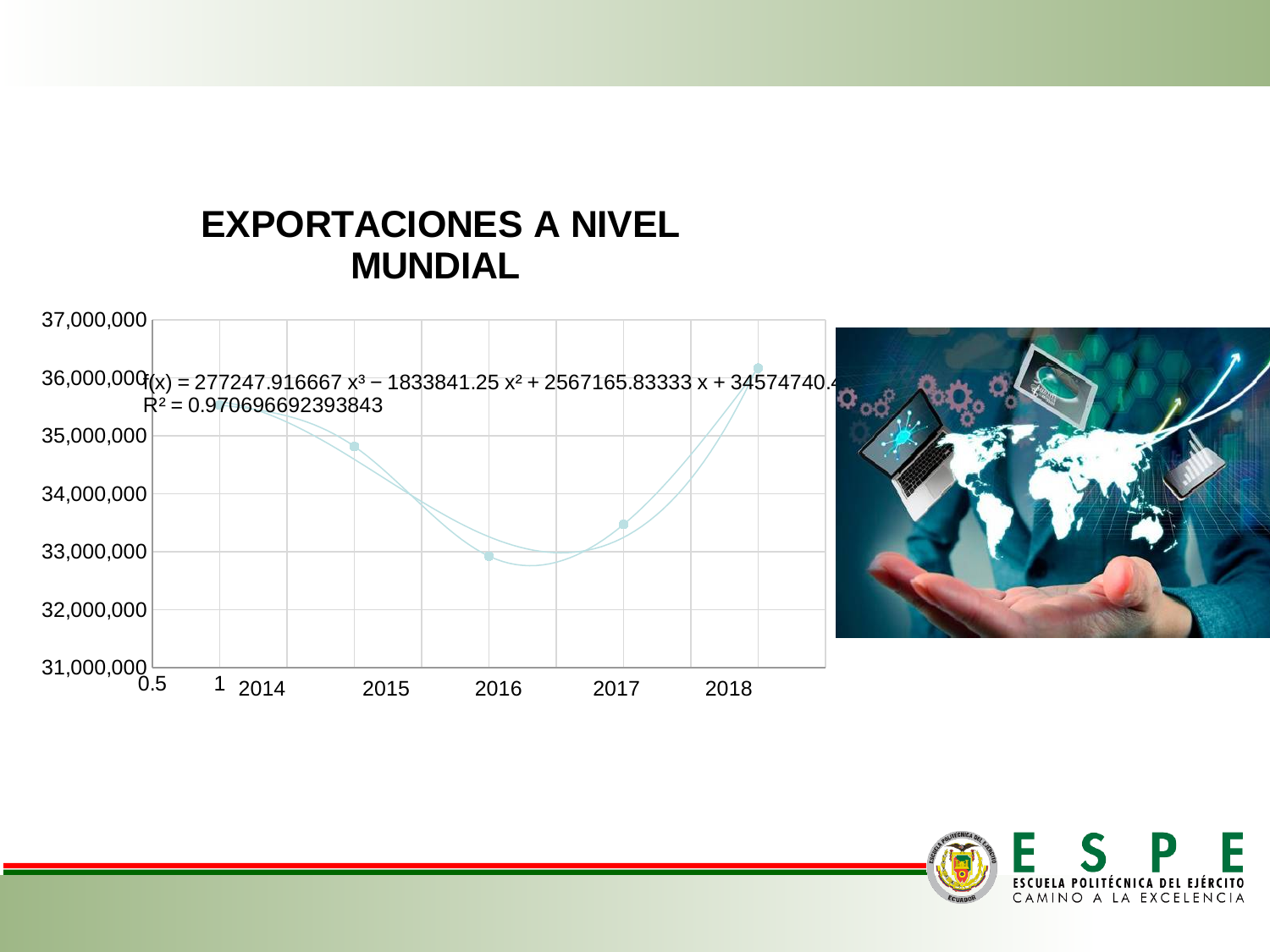
What R² value is printed on the chart? 0.970696692393843 Which year has the highest value on the chart? 2018 Do the values rise or fall from 2014 to 2016? fall Is the value for 2016 greater or less than 34,000,000? less What is the title of the chart? EXPORTACIONES A NIVEL MUNDIAL Which is larger, the value for 2015 or the value for 2017? 2015 Is the value for 2015 greater or less than 34,000,000? greater How many data points are plotted on the chart? 5 What kind of chart is shown on the slide? line chart Is the value for 2018 greater or less than 35,000,000? greater Which year has the lowest value on the chart? 2016